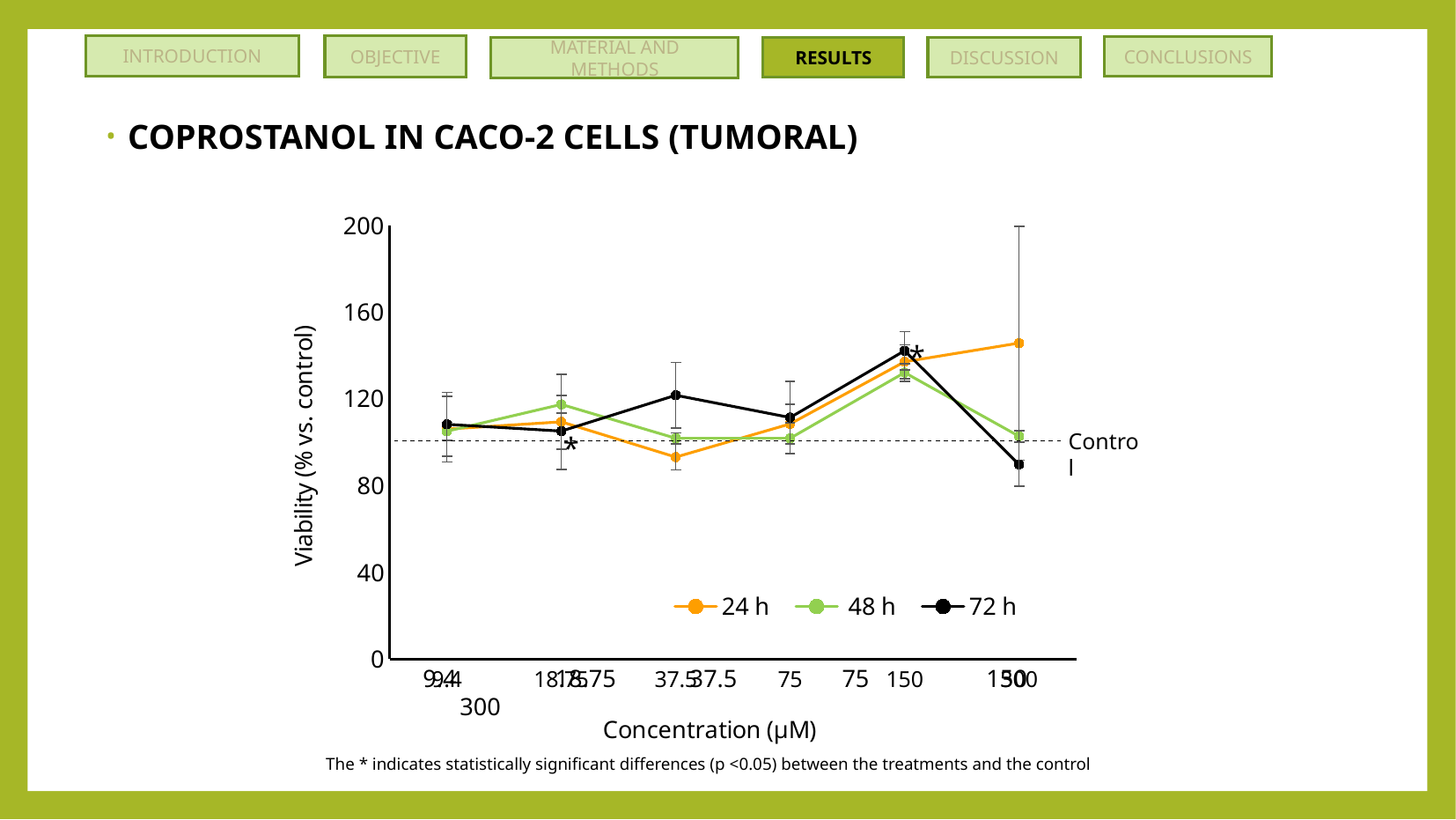
What are the three series named in the legend? 24 h, 48 h, 72 h How many data points does each series have? 6 At which concentration does the 72 h series reach its lowest value? 300 At the rightmost point (300 µM), which series has the larger value, 24 h or 72 h? 24 h What type of chart is shown on the slide? line chart What is the title of the y axis? Viability (% vs. control) Is the 48 h value at 150 µM greater or less than 120? greater Is the 24 h value at the rightmost point (300 µM) greater or less than 120? greater How many series does the legend list? 3 Is the 24 h value at the third point (37.5 µM) greater or less than 100? less At which concentration does the 72 h series reach its highest value? 150